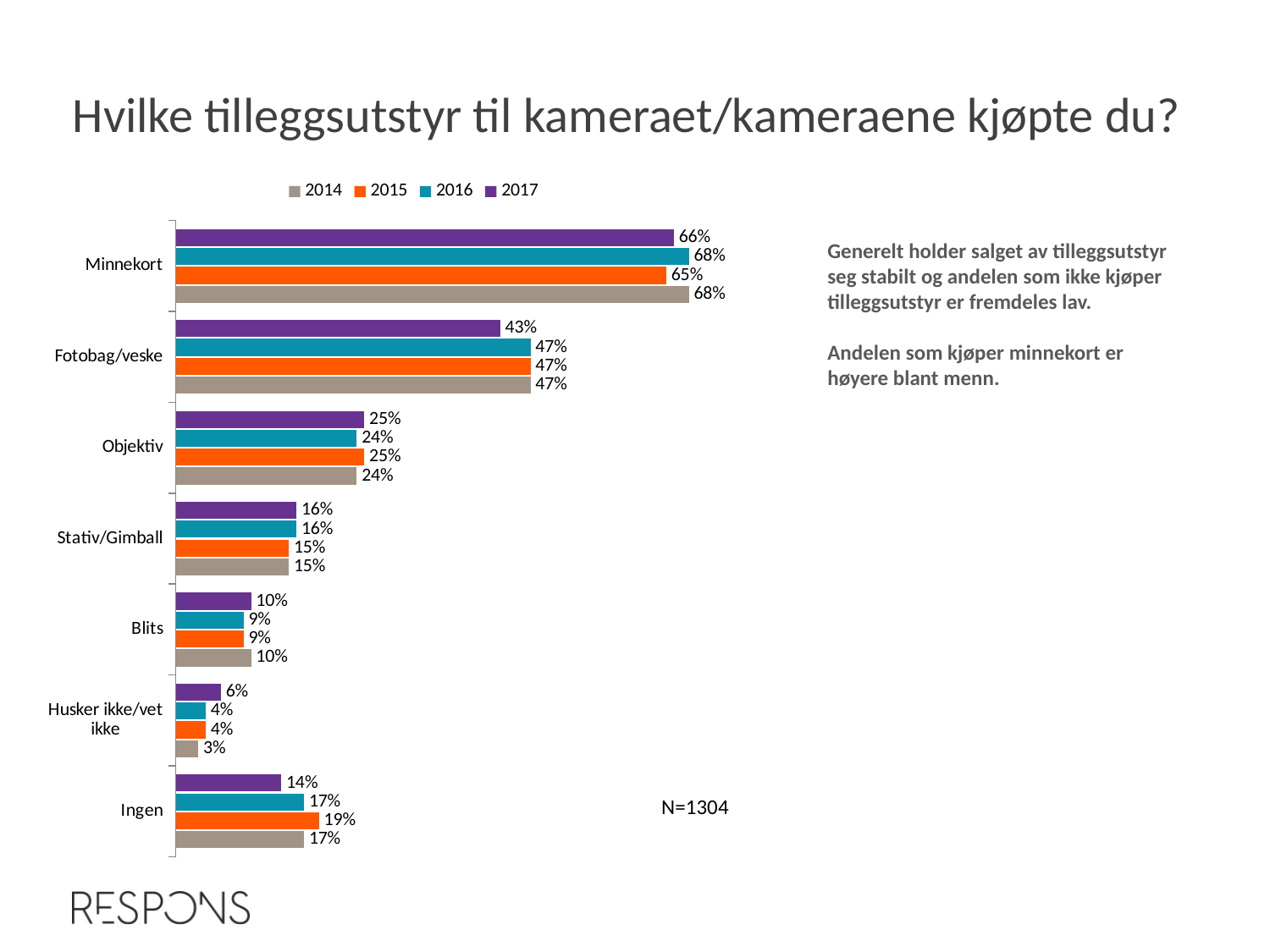
What is the value for Ingen in 2015? 19% What is the value for Fotobag/veske in 2014? 47% Which is larger for Ingen: the 2015 value or the 2017 value? 2015 What sample size (N) is shown on the slide? N=1304 What is the value for Minnekort in 2017? 66% What kind of chart is shown on the slide? Bar chart How many categories are shown on the chart? 7 What is the difference between the 2016 and 2017 values for Minnekort? 2% Which category has the lowest value in 2014? Husker ikke/vet ikke How many series does the legend list? 4 Which category has the highest value in 2016? Minnekort What is the value for Husker ikke/vet ikke in 2016? 4%